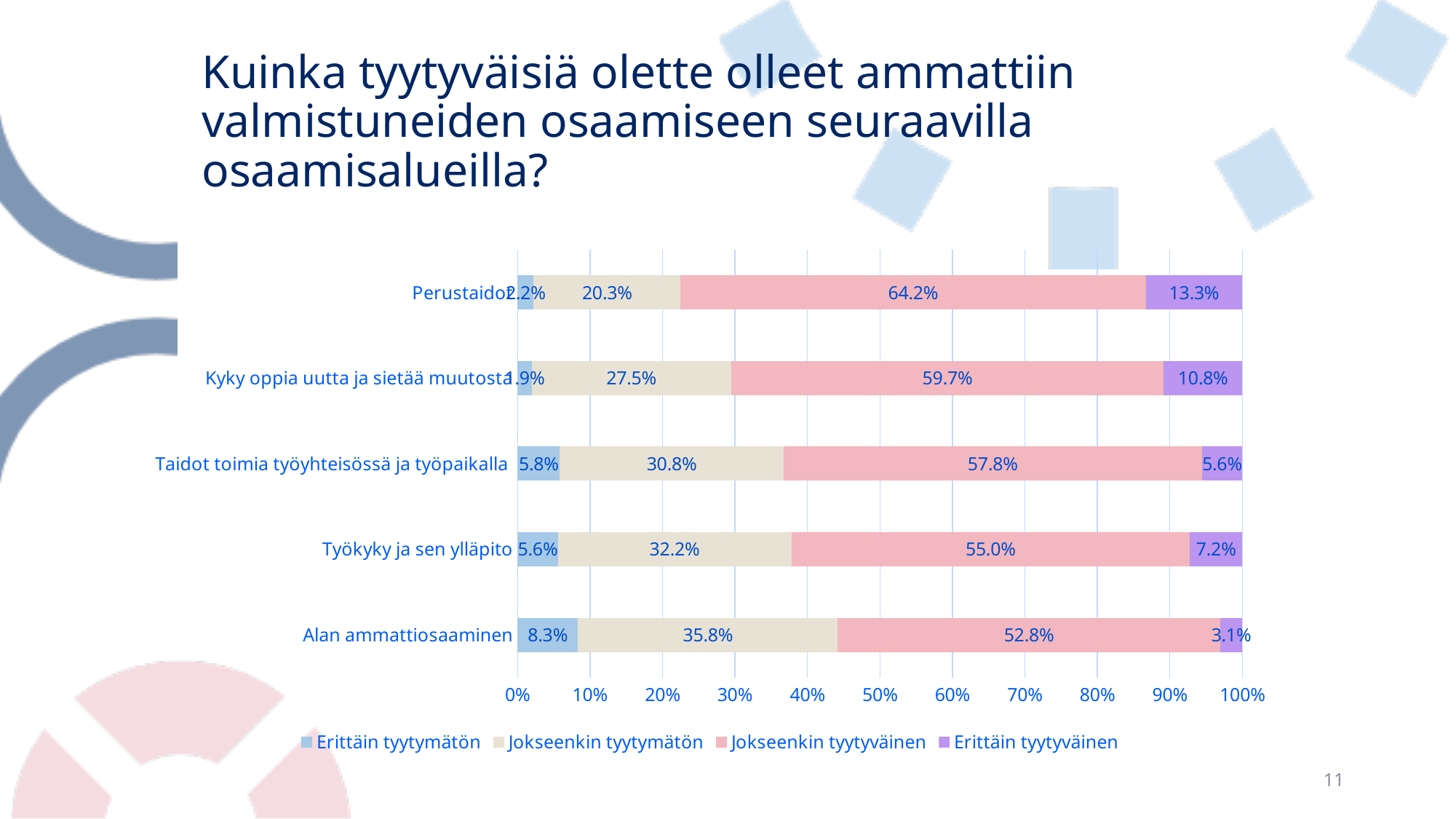
What is the value of 'Erittäin tyytymätön' for Työkyky ja sen ylläpito? 5.6% Which category has the lowest 'Erittäin tyytyväinen' value? Alan ammattiosaaminen How many categories are plotted on the chart? 5 Which legend entry is shown in purple? Erittäin tyytyväinen What is the difference between the 'Jokseenkin tyytymätön' values for Alan ammattiosaaminen and Perustaidot? 15.5% How many series does the legend list? 4 What is the value of 'Jokseenkin tyytyväinen' for Perustaidot? 64.2% What is the value of 'Erittäin tyytyväinen' for Kyky oppia uutta ja sietää muutosta? 10.8% What kind of chart is shown on the slide? Stacked bar chart What is the value of 'Jokseenkin tyytymätön' for Alan ammattiosaaminen? 35.8% Which is larger: the 'Erittäin tyytyväinen' value for Perustaidot or for Taidot toimia työyhteisössä ja työpaikalla? Perustaidot Which category has the highest 'Jokseenkin tyytyväinen' value? Perustaidot